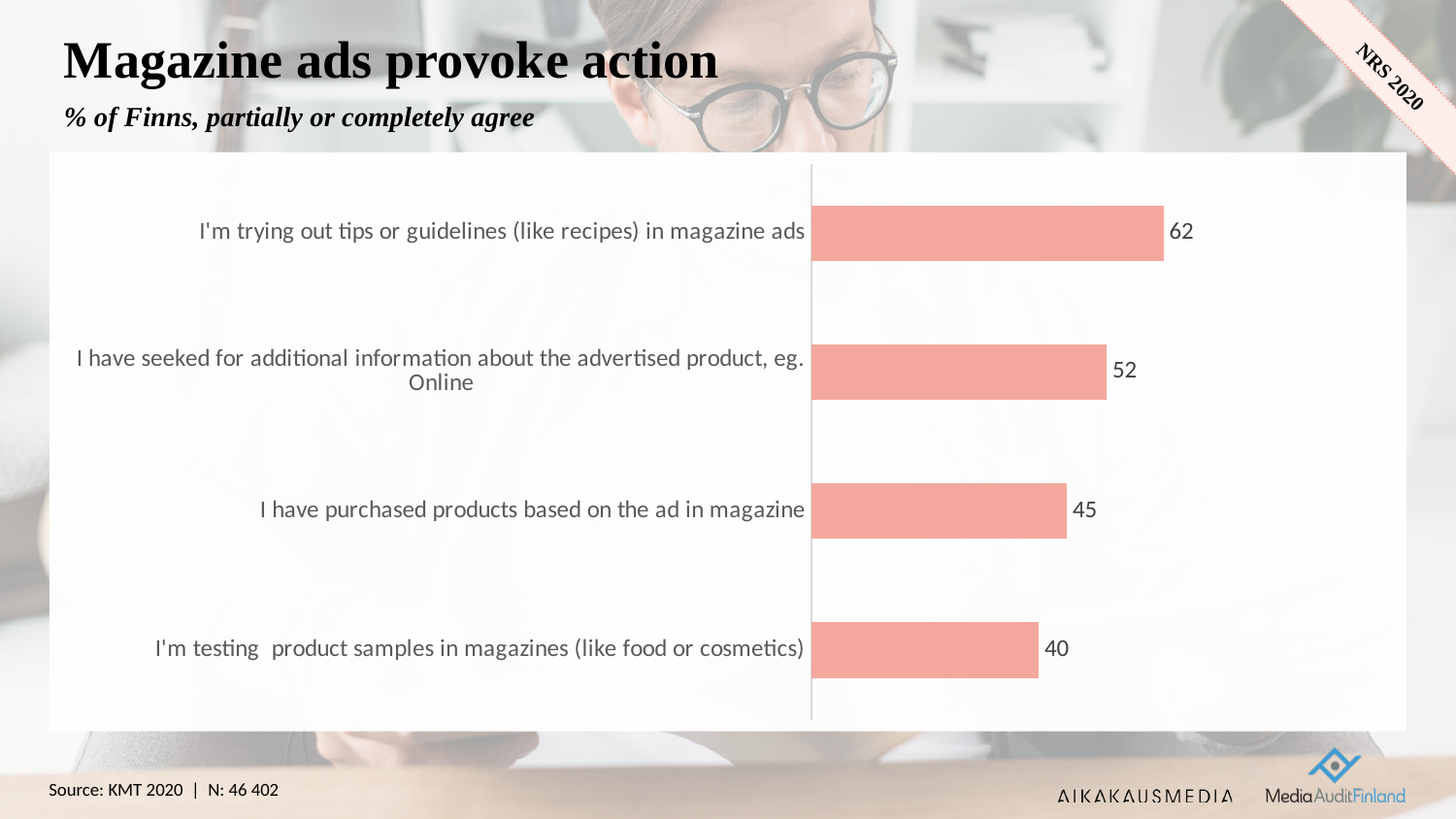
Which is larger: the value for purchasing products based on the ad or the value for testing product samples? I have purchased products based on the ad in magazine What type of chart is shown on the slide? Bar chart What is the title of the slide? Magazine ads provoke action Which statement has the lowest share of agreement? I'm testing product samples in magazines (like food or cosmetics) What is the value for "I have purchased products based on the ad in magazine"? 45 What is the value for "I'm testing product samples in magazines (like food or cosmetics)"? 40 What is the difference between the values for seeking additional information and purchasing products based on the ad? 7 What is the difference between the values for trying out tips or guidelines and testing product samples? 22 Which statement has the highest share of agreement? I'm trying out tips or guidelines (like recipes) in magazine ads What is the value for "I have seeked for additional information about the advertised product, eg. Online"? 52 How many statements are shown in the chart? 4 What percentage of Finns agree with "I'm trying out tips or guidelines (like recipes) in magazine ads"? 62